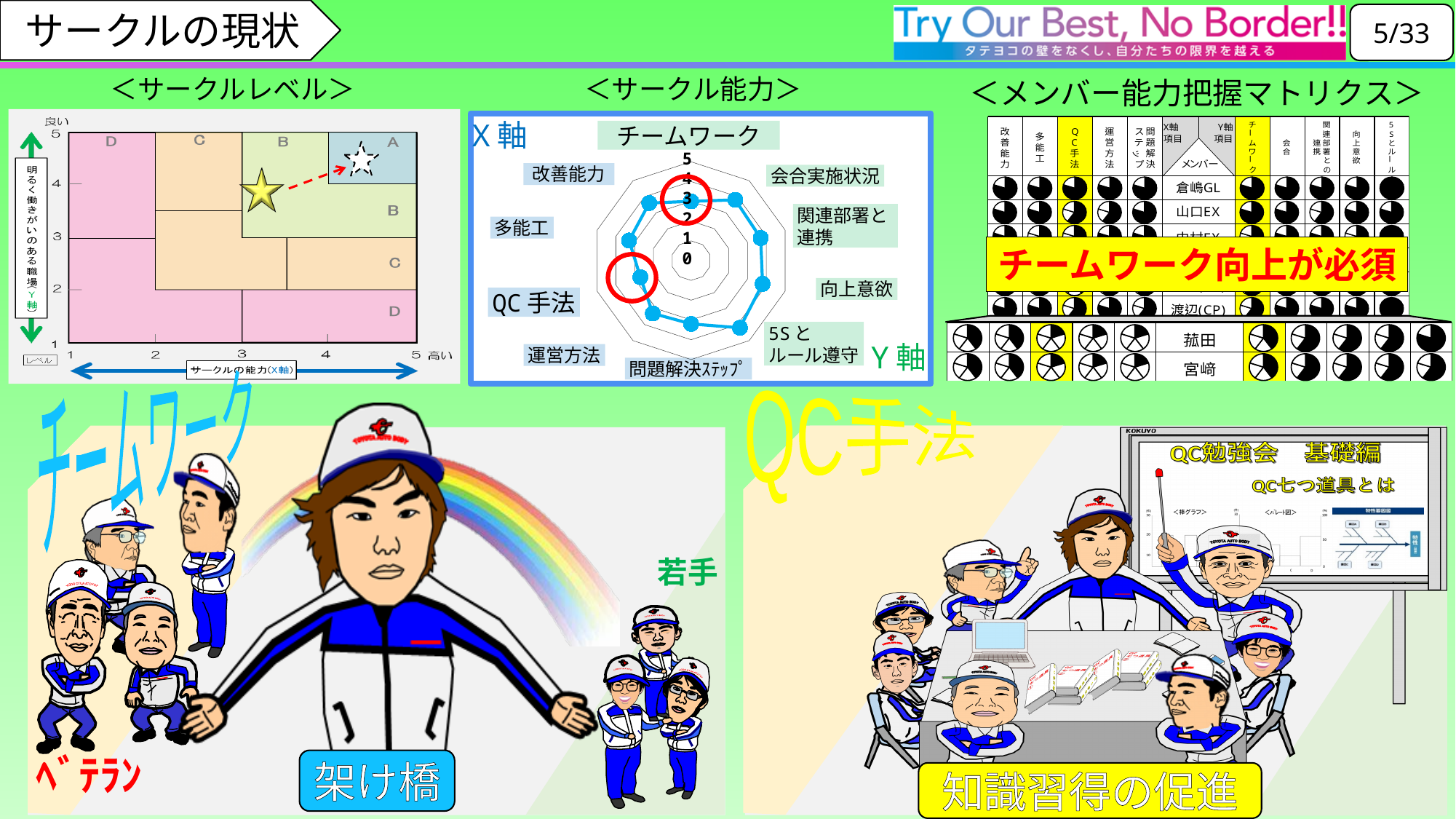
In the ＜サークル能力＞ radar chart, is the value for 5Sとルール遵守 greater or less than 3? greater In the ＜サークル能力＞ radar chart, is the value for 会合実施状況 greater or less than 3? greater How many categories (axes) does the ＜サークル能力＞ radar chart have? 10 In the ＜サークル能力＞ radar chart, which is larger, the value for QC手法 or the value for チームワーク? チームワーク In the ＜サークル能力＞ radar chart, what is the value for チームワーク? 3 What is the maximum value on the scale of the ＜サークル能力＞ radar chart? 5 What kind of chart is the ＜サークル能力＞ chart? radar chart In the ＜サークル能力＞ radar chart, is the value for QC手法 greater or less than 3? less What is the label of the horizontal axis in the ＜サークルレベル＞ chart? サークルの能力(X軸) In the ＜サークル能力＞ radar chart, which category has the lowest value? QC手法 In the ＜サークル能力＞ radar chart, which is larger, the value for チームワーク or the value for 向上意欲? 向上意欲